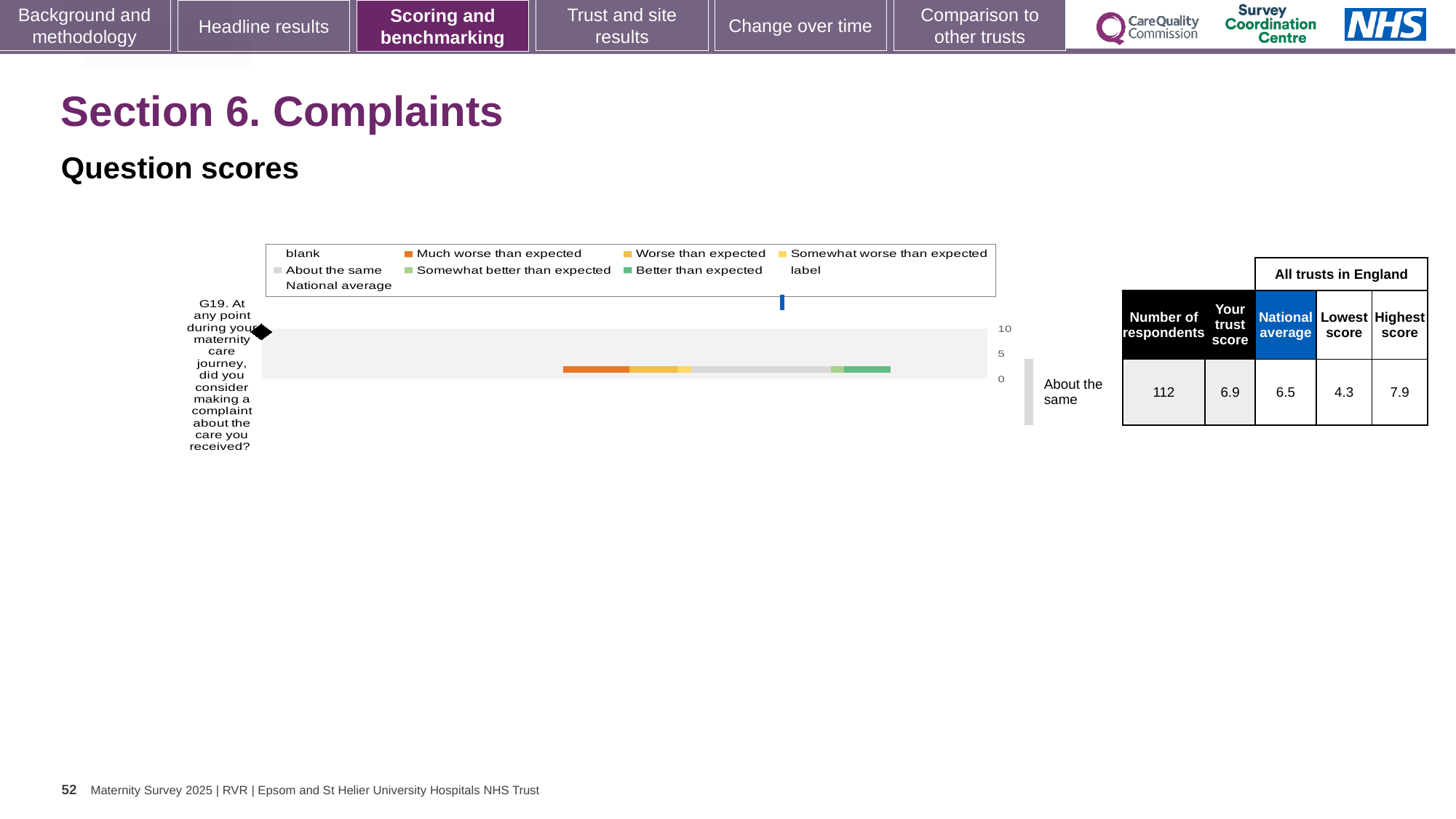
What benchmark category is the trust's result for question G19 placed in? About the same What is the national average score for question G19? 6.5 What is the lowest score among all trusts in England for question G19? 4.3 What is the highest score among all trusts in England for question G19? 7.9 What is the trust's score for question G19 according to the table beside the chart? 6.9 Which is larger for question G19: the trust score or the national average? the trust score Which legend entry is shown in orange? Much worse than expected How many respondents answered question G19? 112 What kind of chart is shown on the slide? bar chart How many question categories are plotted on the chart? 1 What is the difference between the highest score and the lowest score for question G19? 3.6 What is the highest tick value shown on the chart's axis? 10